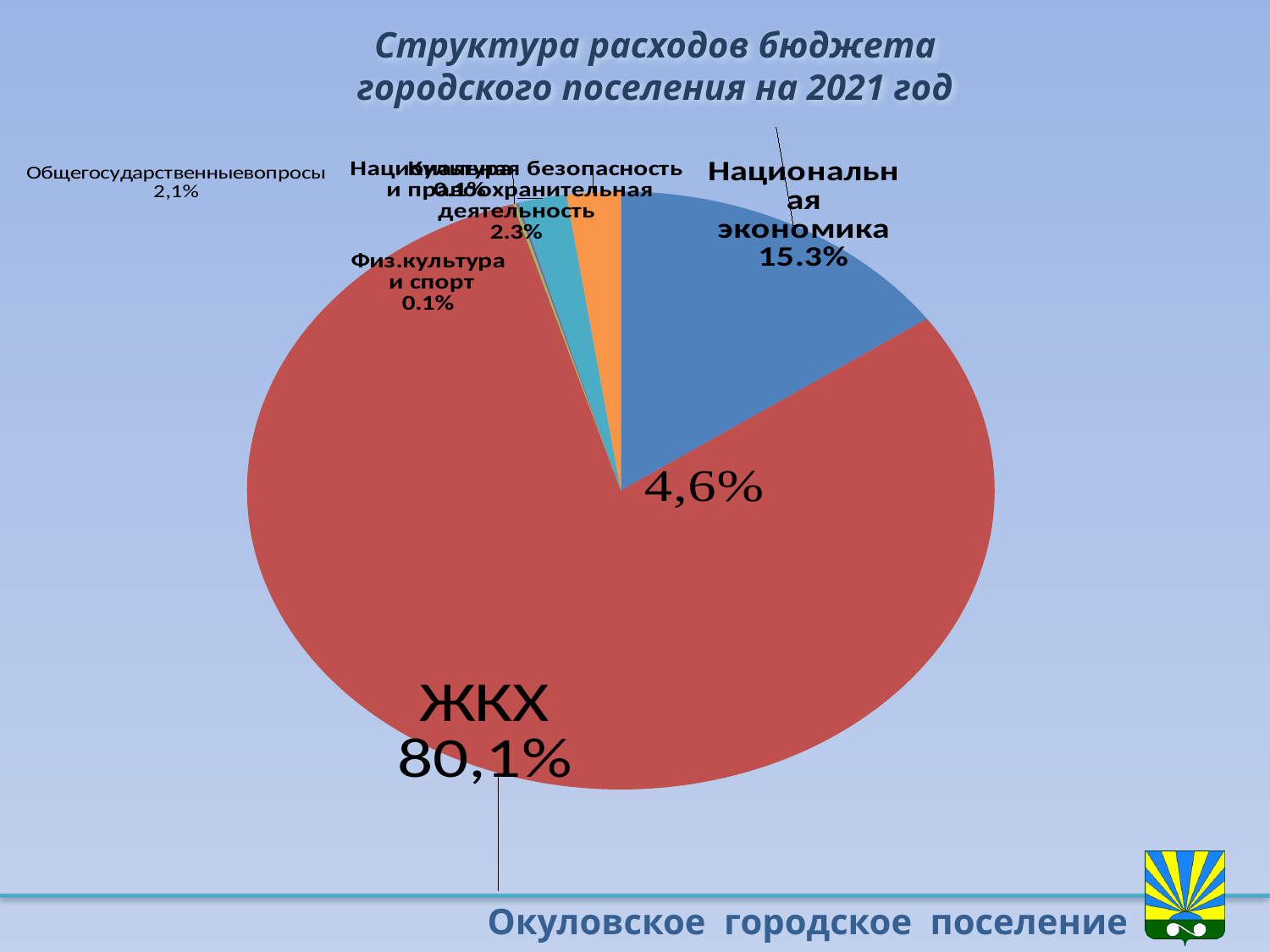
By how many percentage points does the share for ЖКХ exceed the share for Национальная экономика? 64.8 percentage points What share is shown for Национальная безопасность и правоохранительная деятельность? 2.3% What colour is the ЖКХ slice of the pie? Red What share is shown for Физ.культура и спорт? 0.1% Which is larger, the share for Национальная безопасность и правоохранительная деятельность or the share for Общегосударственные вопросы? Национальная безопасность и правоохранительная деятельность What share is shown for Национальная экономика? 15.3% Which is larger, the share for ЖКХ or the share for Национальная экономика? ЖКХ What is the title of the chart? Структура расходов бюджета городского поселения на 2021 год What kind of chart is shown on the slide? Pie chart Which category has the largest share of the pie? ЖКХ What share of the budget expenditure does ЖКХ account for? 80,1% What share is shown for Общегосударственные вопросы? 2,1%